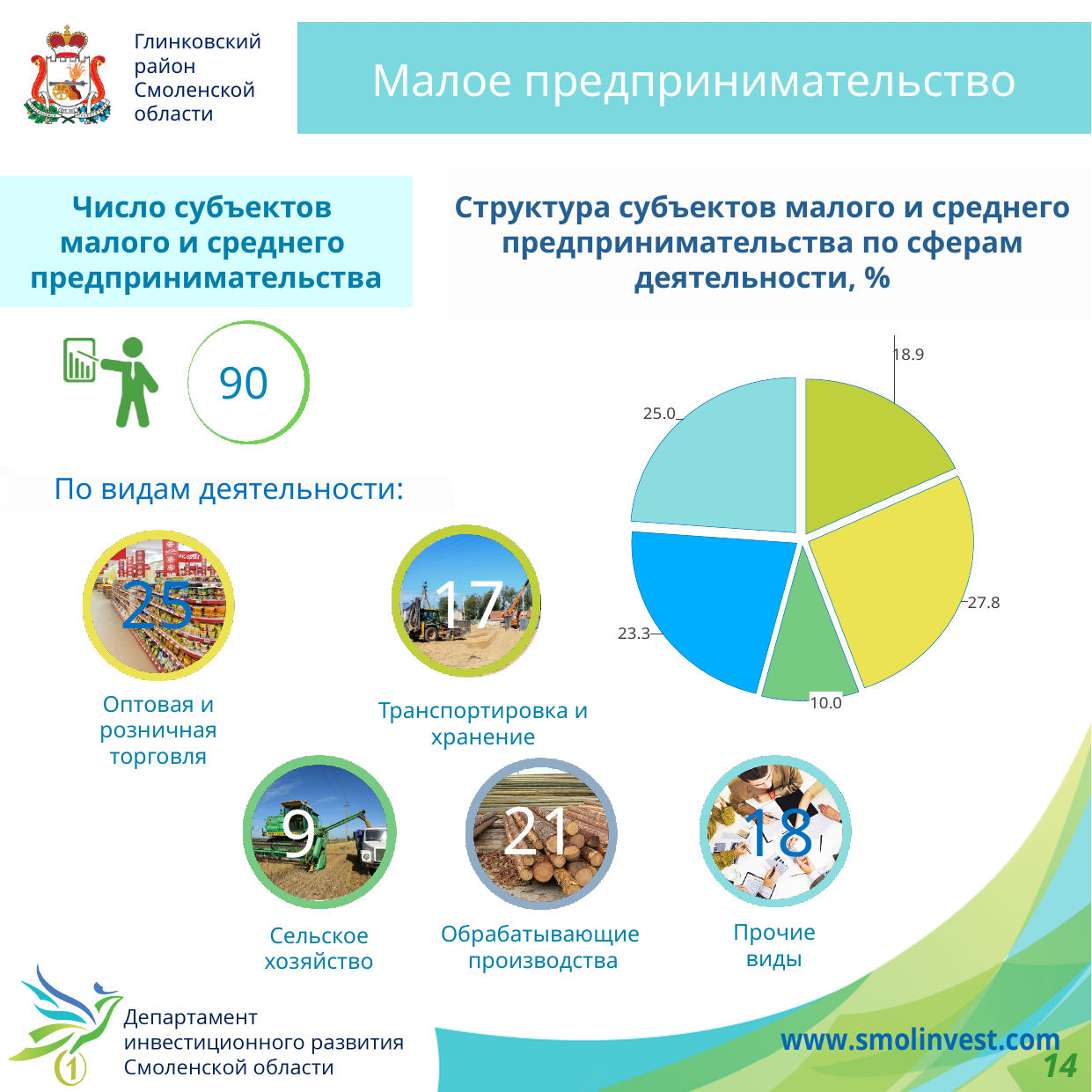
What is the difference between the slices labelled 27.8 and 25.0 in the pie chart? 2.8 What value is labelled on the green slice of the pie chart? 10.0 What value is labelled on the light blue slice of the pie chart? 25.0 What kind of chart is shown on the slide? pie chart What is the largest value labelled on the pie chart? 27.8 How many slices does the pie chart have? 5 Which is larger in the pie chart: the slice labelled 25.0 or the slice labelled 23.3? 25.0 What is the title of the pie chart? Структура субъектов малого и среднего предпринимательства по сферам деятельности, % What is the difference between the largest slice (27.8) and the smallest slice (10.0) in the pie chart? 17.8 What value is labelled on the olive-green slice of the pie chart? 18.9 What is the smallest value labelled on the pie chart? 10.0 What value is labelled on the dark blue slice of the pie chart? 23.3